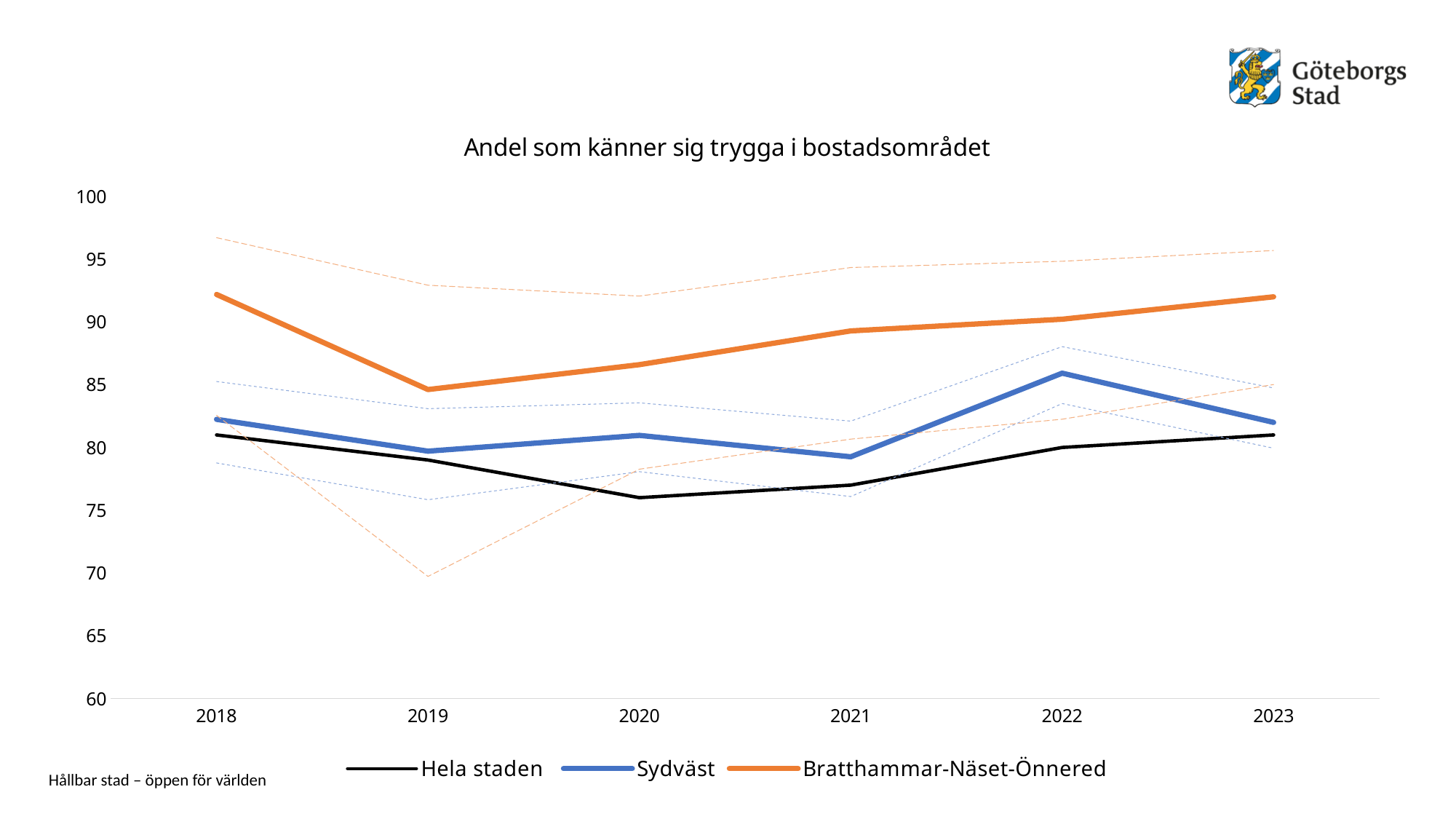
Does the Bratthammar-Näset-Önnered line rise or fall from 2019 to 2023? rise Is the value for Hela staden in 2020 greater or less than 80? less How many years are shown on the x axis? 6 What kind of chart is shown on the slide? line chart How many series does the legend list? 3 In which year is the Bratthammar-Näset-Önnered line at its lowest? 2019 Is the value for Sydväst in 2022 greater or less than 85? greater Is the value for Bratthammar-Näset-Önnered in 2018 greater or less than 90? greater Which series is drawn in orange? Bratthammar-Näset-Önnered In 2022, which is higher: Sydväst or Bratthammar-Näset-Önnered? Bratthammar-Näset-Önnered What is the title of the chart? Andel som känner sig trygga i bostadsområdet In which year is the Sydväst line at its highest? 2022